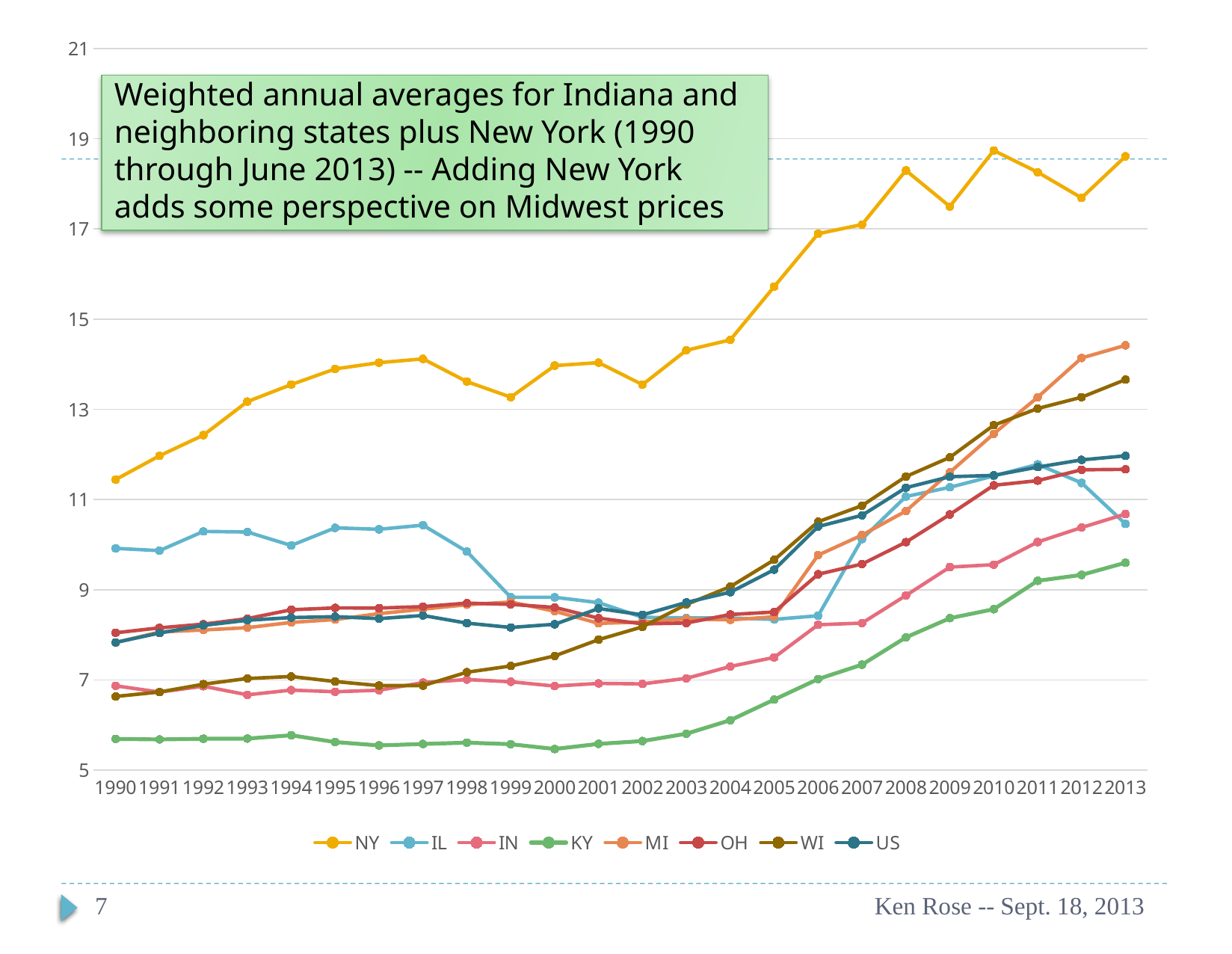
Does the KY series rise or fall from 2005 to 2013? Rise How many years are shown along the x axis? 24 Which series has the highest value in 2013? NY Is the value for NY in 2013 greater or less than 17? greater Which series has the lowest value in 1990? KY In 2005, which is higher: IN or KY? IN Is the value for MI in 2013 greater or less than 13? greater How many series does the legend list? 8 Is the value for KY in 1990 greater or less than 7? less What kind of chart is shown on the slide? Line chart Which series has the lowest value in 2013? KY In 2013, which is higher: MI or WI? MI